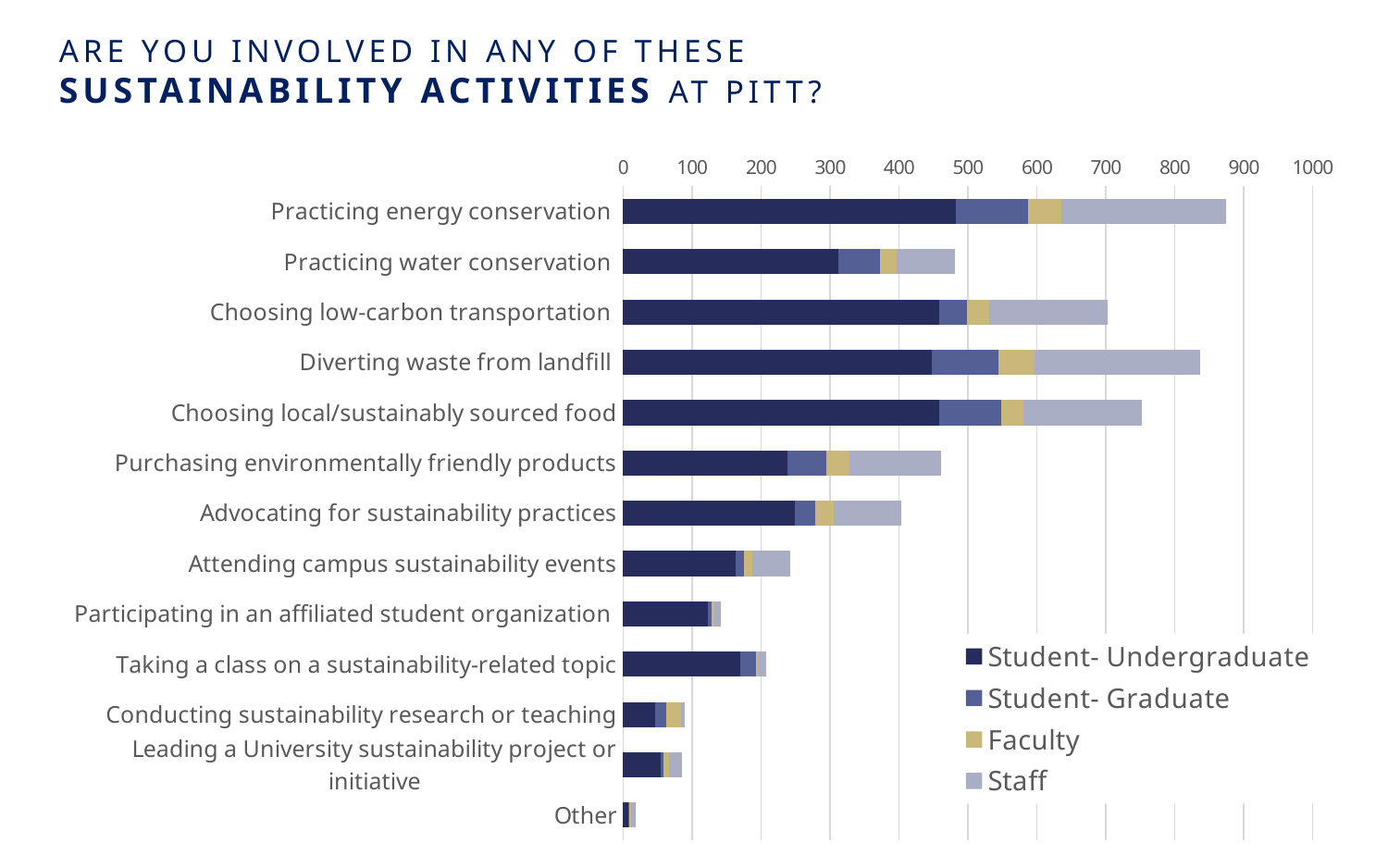
Which activity has the shortest total bar? Other Is the total bar for Practicing energy conservation greater or less than 800? greater How many series does the legend list? 4 Is the total bar for Attending campus sustainability events greater or less than 200? greater Is the Student- Undergraduate segment for Practicing energy conservation greater or less than 400? greater How many activity categories are plotted on the chart? 13 Which legend entry is shown in the darkest colour? Student- Undergraduate What kind of chart is shown on the slide? Stacked bar chart Which has the longer total bar: Choosing local/sustainably sourced food or Choosing low-carbon transportation? Choosing local/sustainably sourced food Which activity has the longest total bar? Practicing energy conservation